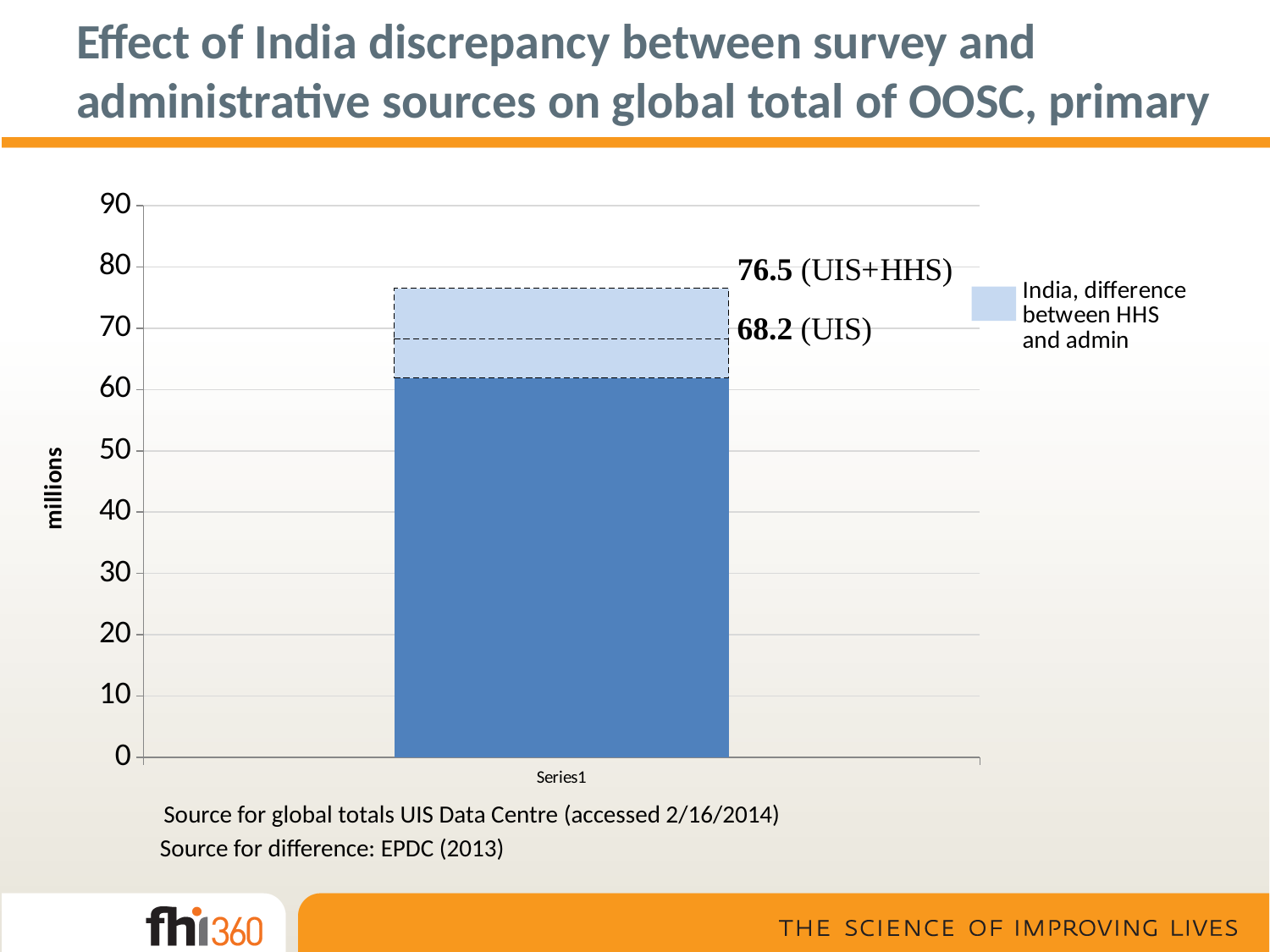
Is the top of the dark blue bar segment greater or less than 60? greater What does the legend entry on the chart say? India, difference between HHS and admin What is the label on the vertical axis of the chart? millions What is the global total of OOSC labelled as UIS on the chart? 68.2 Which is larger, the UIS+HHS value or the UIS value? UIS+HHS What is the difference between the UIS+HHS value and the UIS value shown on the chart? 8.3 How many entries does the chart legend list? 1 What kind of chart is shown on the slide? bar chart How many bars are plotted on the chart? 1 Is the top of the full stacked bar greater or less than 80? less What is the global total of OOSC labelled as UIS+HHS on the chart? 76.5 Is the top of the dark blue bar segment greater or less than 70? less